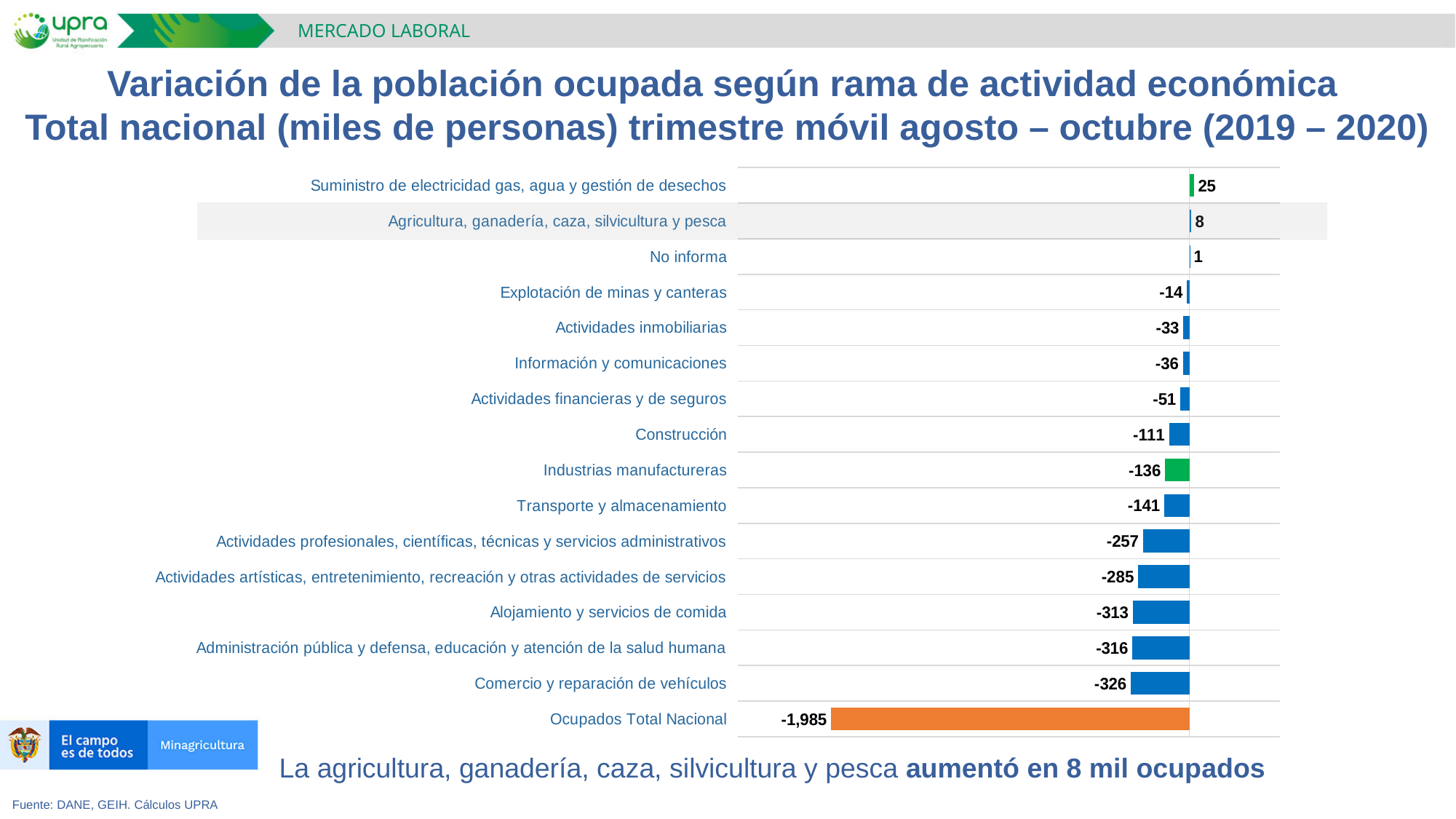
Which category has the highest value? Suministro de electricidad gas, agua y gestión de desechos Which has the larger value, Construcción or Comercio y reparación de vehículos? Construcción How many categories are shown in the chart? 16 What is the value for Ocupados Total Nacional? -1,985 What colour is the bar for Ocupados Total Nacional? Orange What is the value for Industrias manufactureras? -136 What is the difference between the values for Construcción and Transporte y almacenamiento? 30 What is the difference between the values for Suministro de electricidad gas, agua y gestión de desechos and Agricultura, ganadería, caza, silvicultura y pesca? 17 What kind of chart is shown on the slide? Bar chart What is the value for Agricultura, ganadería, caza, silvicultura y pesca? 8 Which category has the lowest value? Ocupados Total Nacional What is the value for Comercio y reparación de vehículos? -326